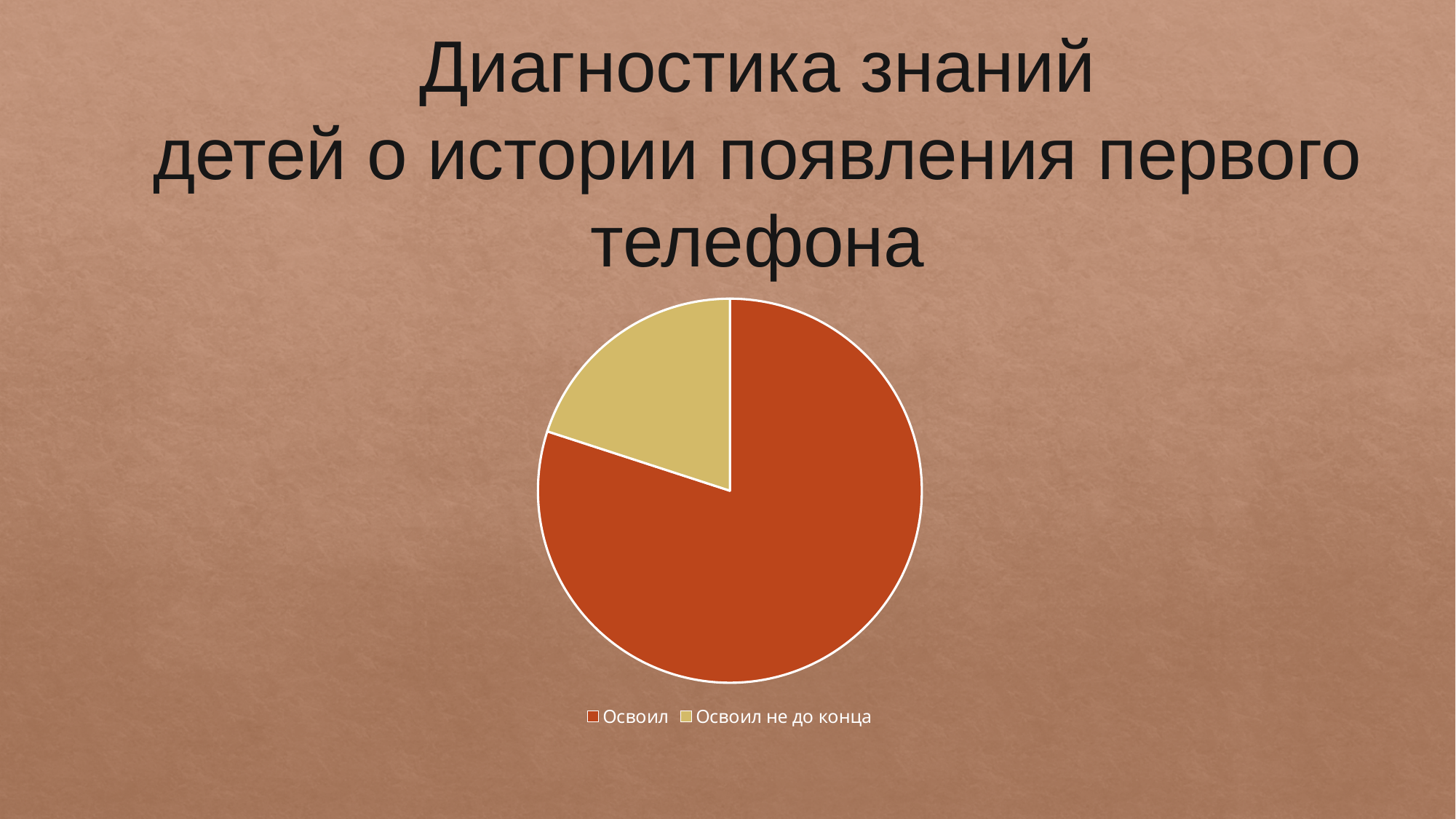
Which category has the smallest slice in the pie chart? Освоил не до конца What colour is the slice for "Освоил не до конца" in the pie chart? yellow How many slices does the pie chart have? 2 How many entries does the legend of the pie chart list? 2 What kind of chart is shown on the slide? pie chart Which category has the largest slice in the pie chart? Освоил What colour is the slice for "Освоил" in the pie chart? orange-red Which slice is larger: "Освоил" or "Освоил не до конца"? Освоил